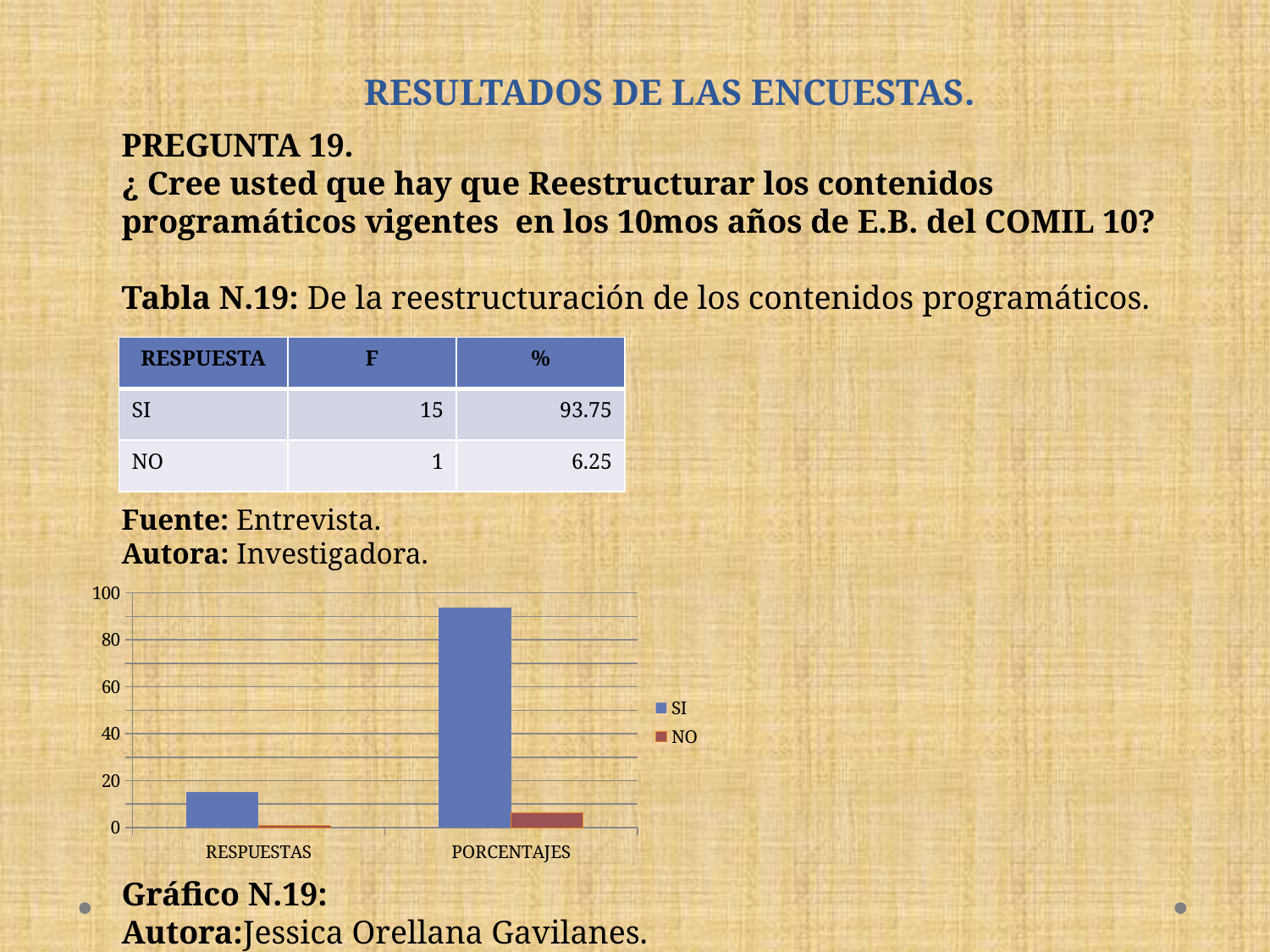
Is the value of the SI bar for PORCENTAJES greater or less than 80? greater For the SI series, which category has the taller bar, RESPUESTAS or PORCENTAJES? PORCENTAJES In the PORCENTAJES category, which series has the larger bar, SI or NO? SI What kind of chart is shown on the slide? bar chart How many series does the chart legend list? 2 Which bar is the tallest in the chart? SI in PORCENTAJES What colour are the SI bars in the chart? blue How many categories are shown on the x axis of the chart? 2 Is the value of the NO bar for PORCENTAJES greater or less than 20? less What are the two entries in the chart legend? SI and NO Is the value of the SI bar for RESPUESTAS greater or less than 20? less Which bar is the shortest in the chart? NO in RESPUESTAS